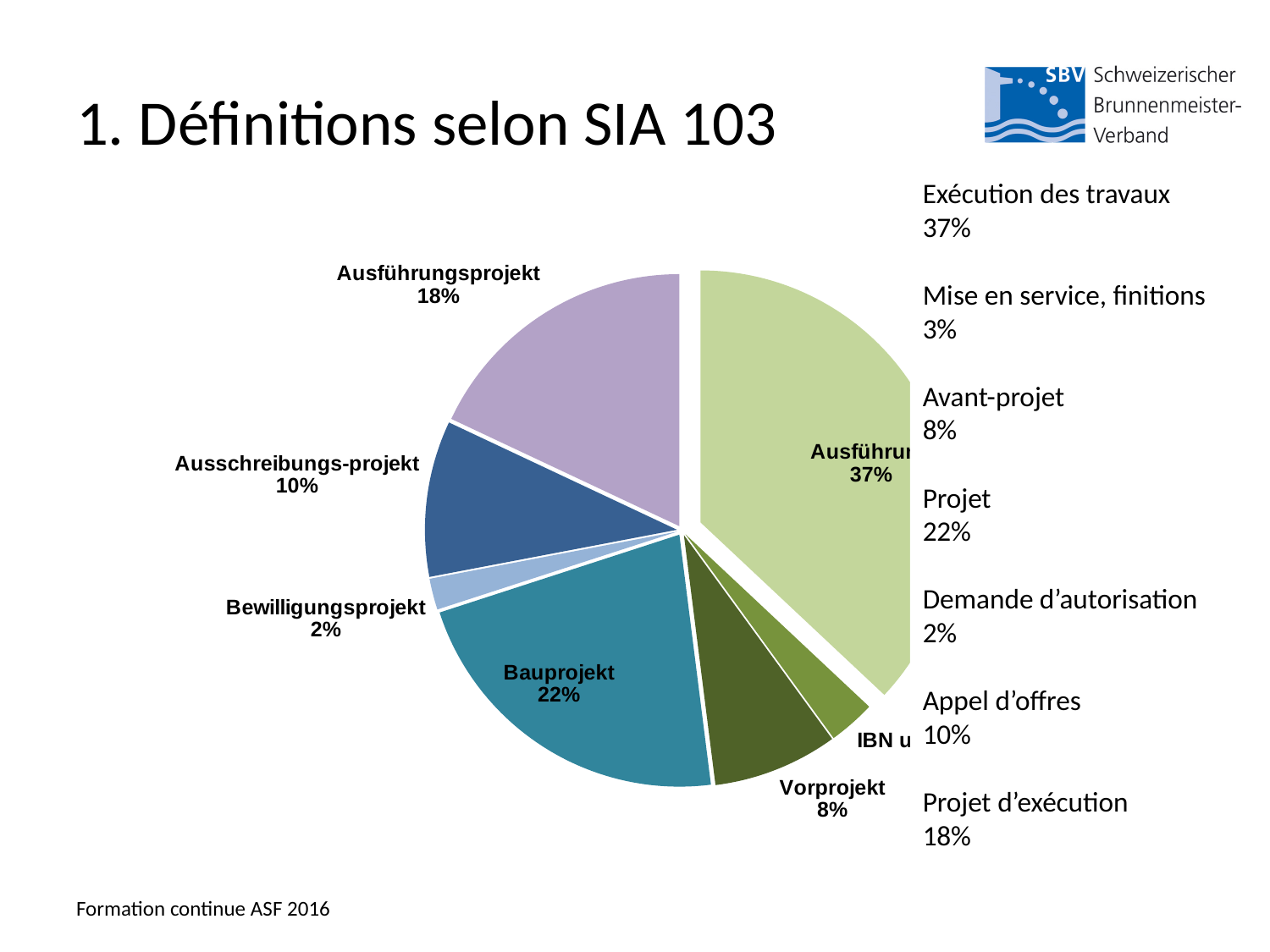
What percentage is shown for the Ausschreibungs-projekt slice? 10% Which slice of the pie chart is the largest? Ausführung (37%) What percentage is shown for the Ausführungsprojekt slice? 18% What percentage is shown for the Bewilligungsprojekt slice? 2% What kind of chart is shown on the slide? pie chart What percentage is shown for the Bauprojekt slice? 22% Which slice of the pie chart is the smallest? Bewilligungsprojekt (2%) What percentage is shown for the Vorprojekt slice? 8% Which is larger, the Ausschreibungs-projekt slice or the Vorprojekt slice? Ausschreibungs-projekt What is the difference in percentage points between the Bauprojekt slice and the Ausführungsprojekt slice? 4 How many slices does the pie chart have? 7 Which slice is pulled out (exploded) from the rest of the pie? Ausführung (37%)